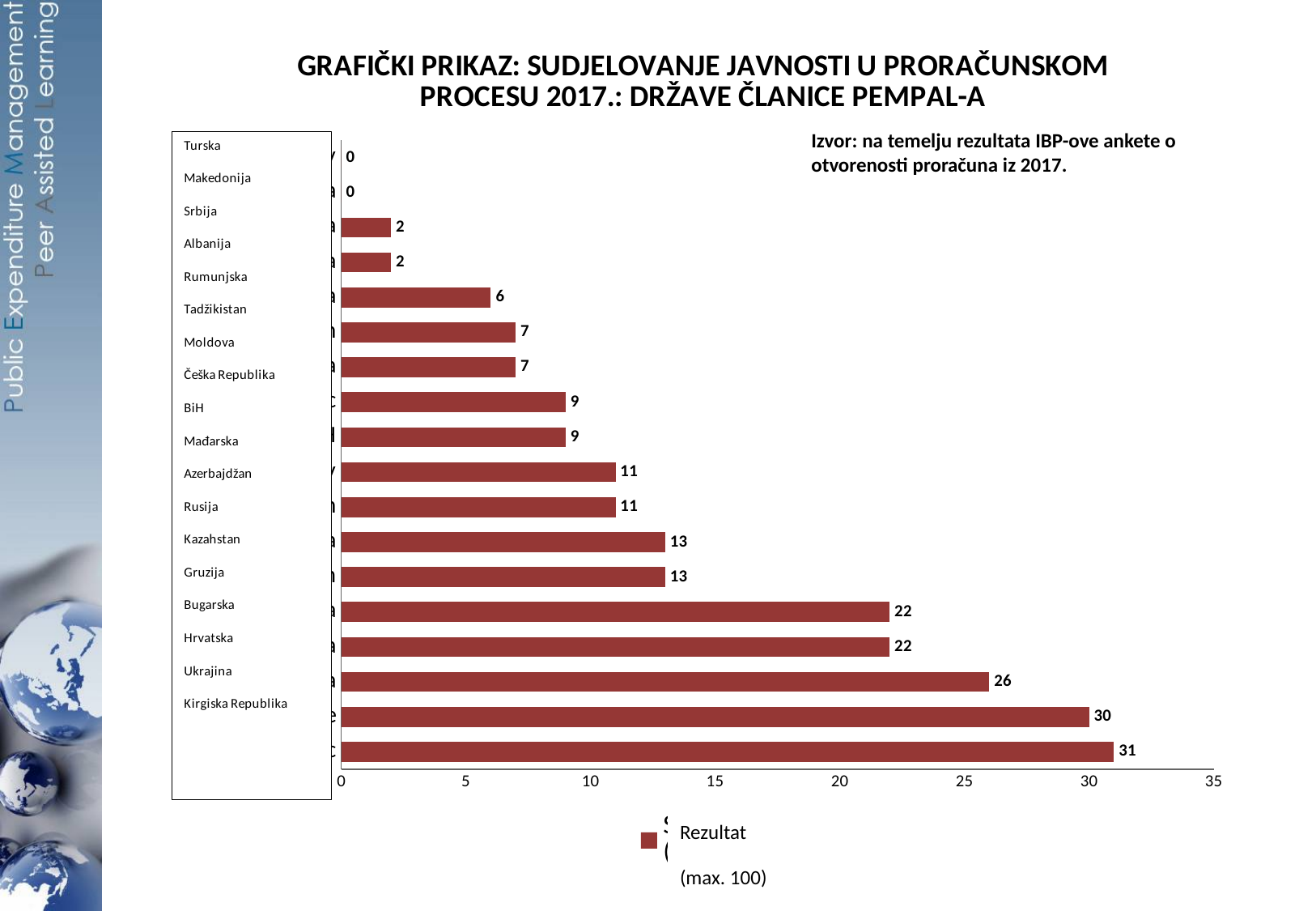
How many countries have a score of 0? 2 What type of chart is shown on the slide? bar chart What is the highest value shown in the chart? 31 What is the name of the series shown in the legend? Rezultat (max. 100) Which has a higher score, Ukrajina or Bugarska? Ukrajina What is the score for Ukrajina? 30 What is the difference between the scores of Kirgiska Republika and Hrvatska? 5 Which country has the highest score in the chart? Kirgiska Republika What is the score for Rumunjska? 6 What is the score for Hrvatska? 26 How many series does the legend list? 1 How many countries (bars) are plotted in the chart? 18